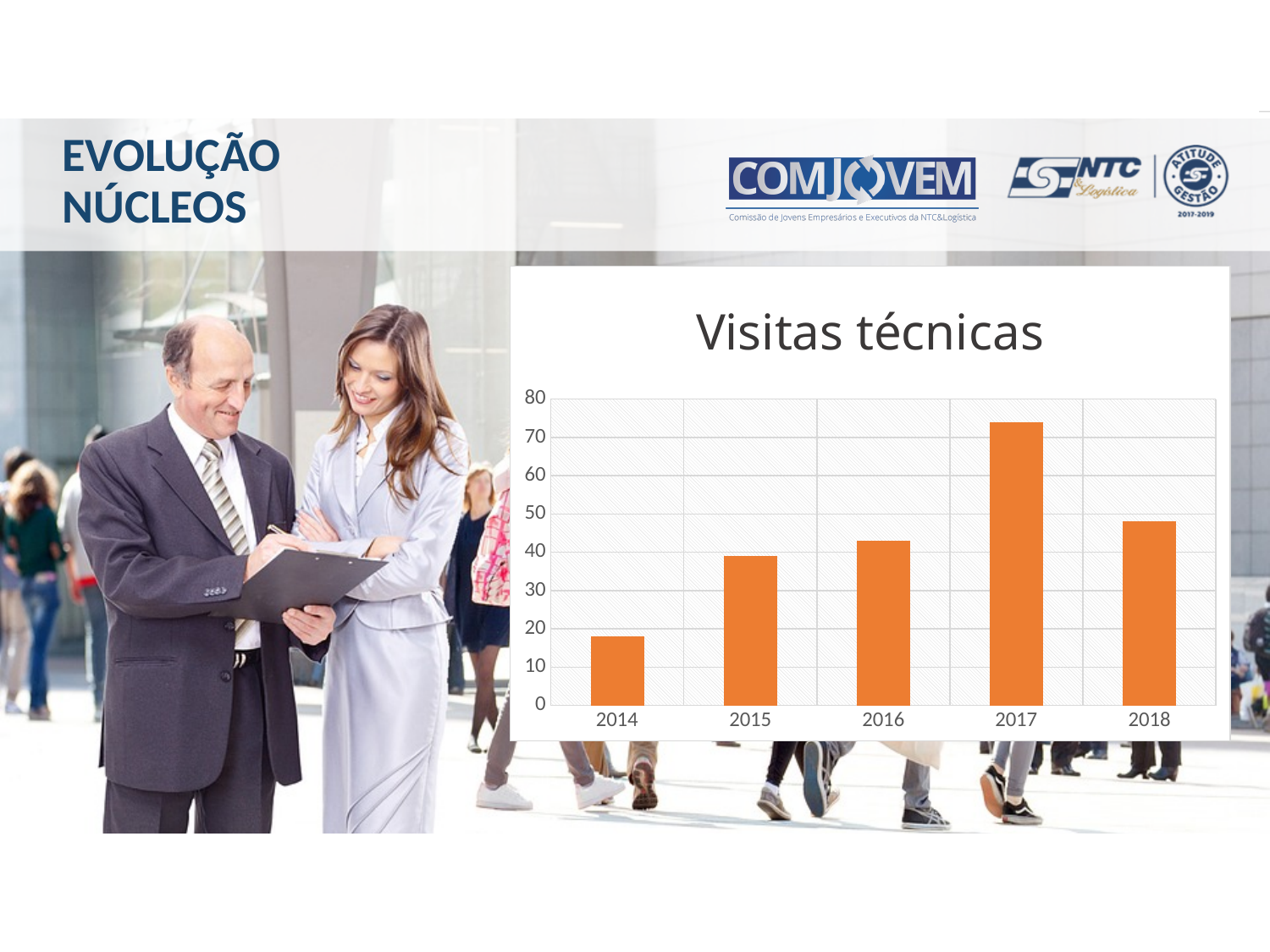
Which is larger, the value for 2016 or the value for 2018? 2018 What is the title of the chart? Visitas técnicas What colour are the bars in the chart? orange Is the value for 2017 greater or less than 70? greater How many years are shown on the x axis of the chart? 5 Do the values rise or fall from 2014 to 2017? rise Which year has the highest value in the chart? 2017 What kind of chart is shown on the slide? bar chart Is the value for 2018 greater or less than 40? greater Which year has the lowest value in the chart? 2014 Is the value for 2014 greater or less than 20? less